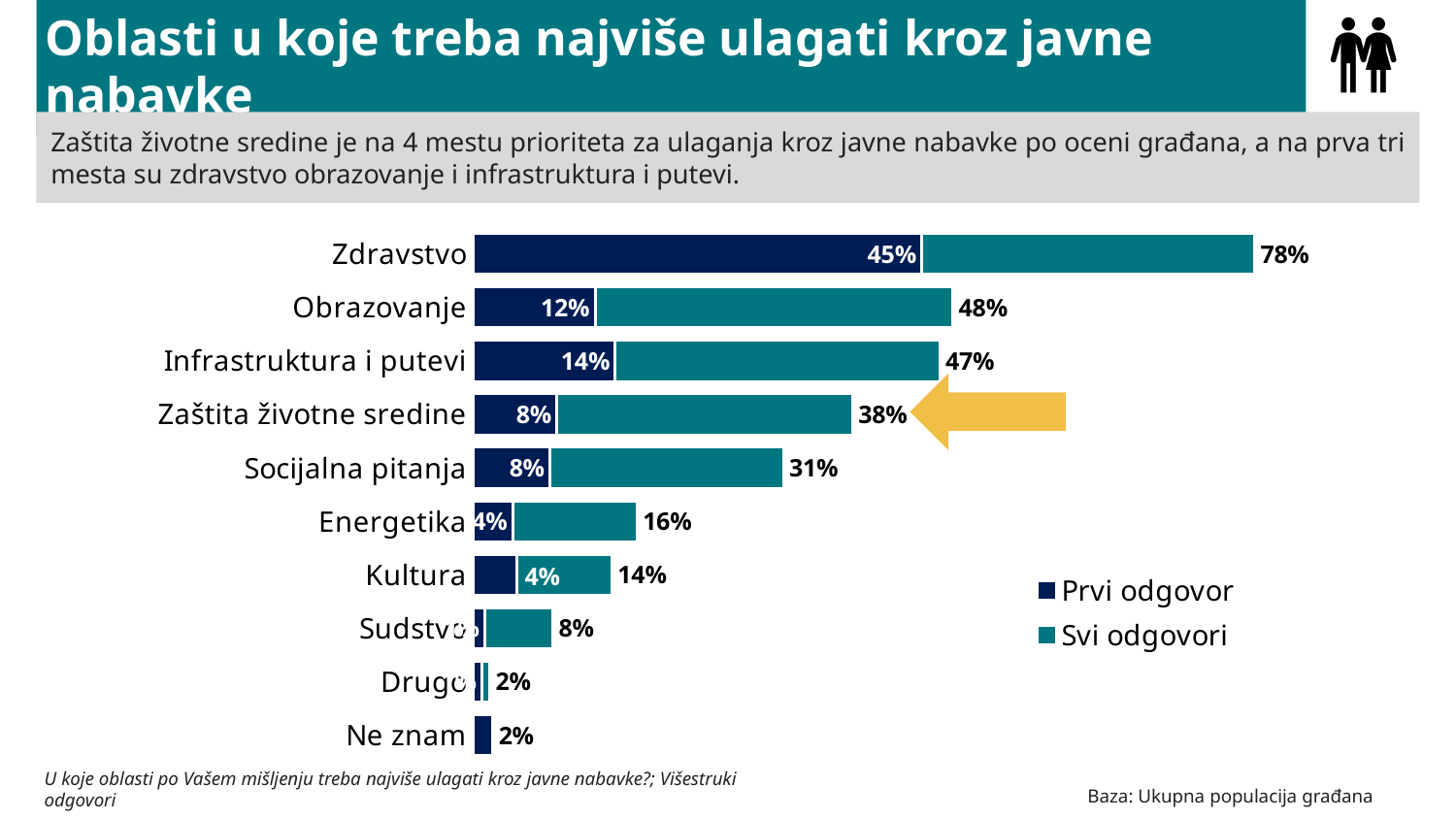
How many series does the legend list? 2 How many categories are shown in the chart? 10 What is the 'Svi odgovori' value for Energetika? 16% Which category has the highest 'Svi odgovori' value? Zdravstvo What is the difference between the 'Svi odgovori' values for Zdravstvo and Obrazovanje? 30 percentage points What kind of chart is shown on the slide? Bar chart What is the 'Svi odgovori' value for Zdravstvo? 78% What is the 'Prvi odgovor' value for Zdravstvo? 45% Which has a higher 'Svi odgovori' value, Obrazovanje or Infrastruktura i putevi? Obrazovanje What is the difference between the 'Prvi odgovor' values for Zdravstvo and Obrazovanje? 33 percentage points What is the 'Prvi odgovor' value for Infrastruktura i putevi? 14% What is the 'Svi odgovori' value for Zaštita životne sredine? 38%